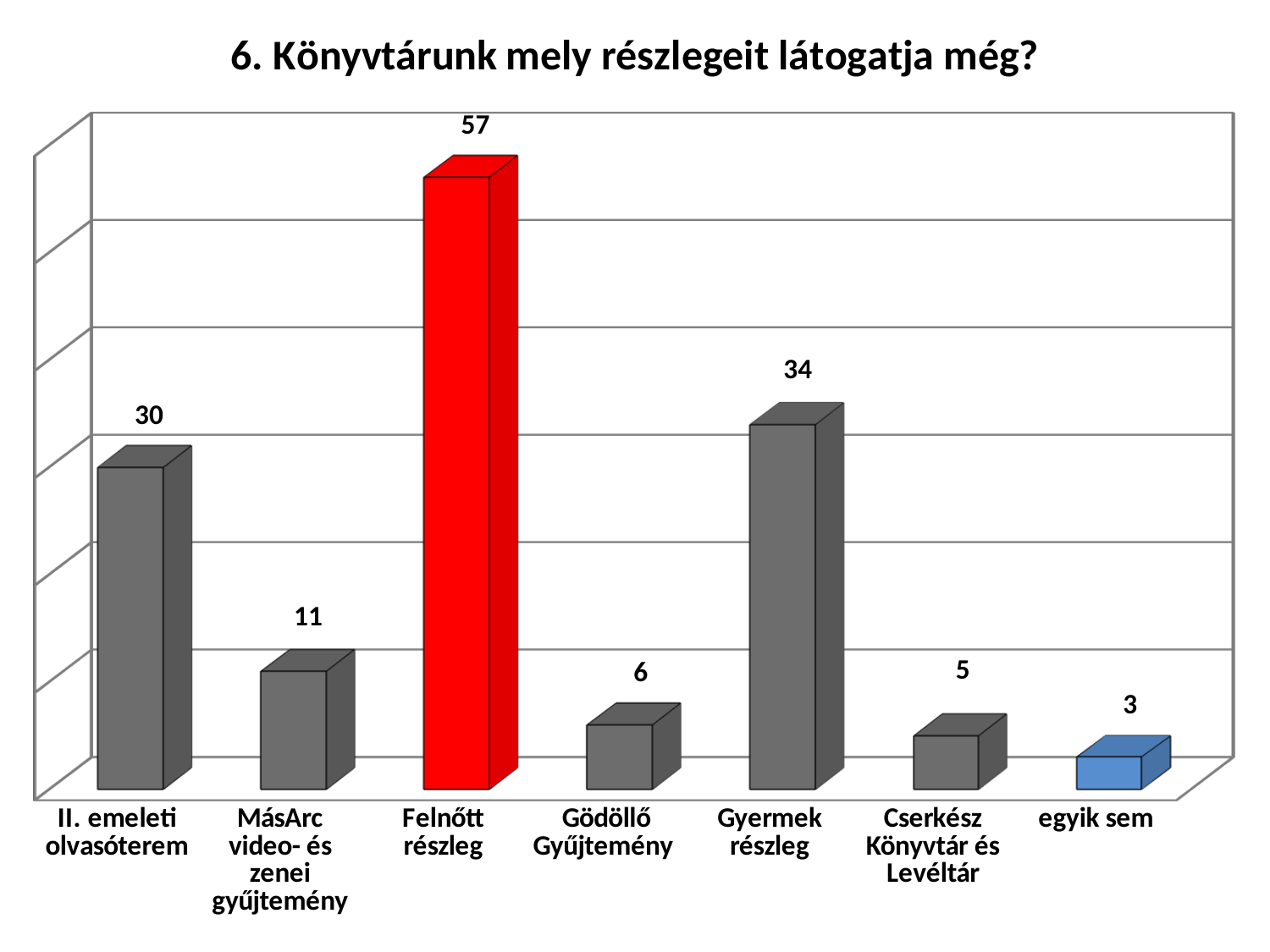
Which category has the highest value? Felnőtt részleg What kind of chart is shown on the slide? bar chart What is the value for egyik sem? 3 What is the difference between the values for Felnőtt részleg and Gyermek részleg? 23 How many categories are shown in the chart? 7 What is the title of the chart? 6. Könyvtárunk mely részlegeit látogatja még? Which is larger, the value for II. emeleti olvasóterem or the value for Gyermek részleg? Gyermek részleg What is the value for Gyermek részleg? 34 Which category has the lowest value? egyik sem Which bar is coloured red? Felnőtt részleg What is the value for Felnőtt részleg? 57 What is the value for MásArc video- és zenei gyűjtemény? 11